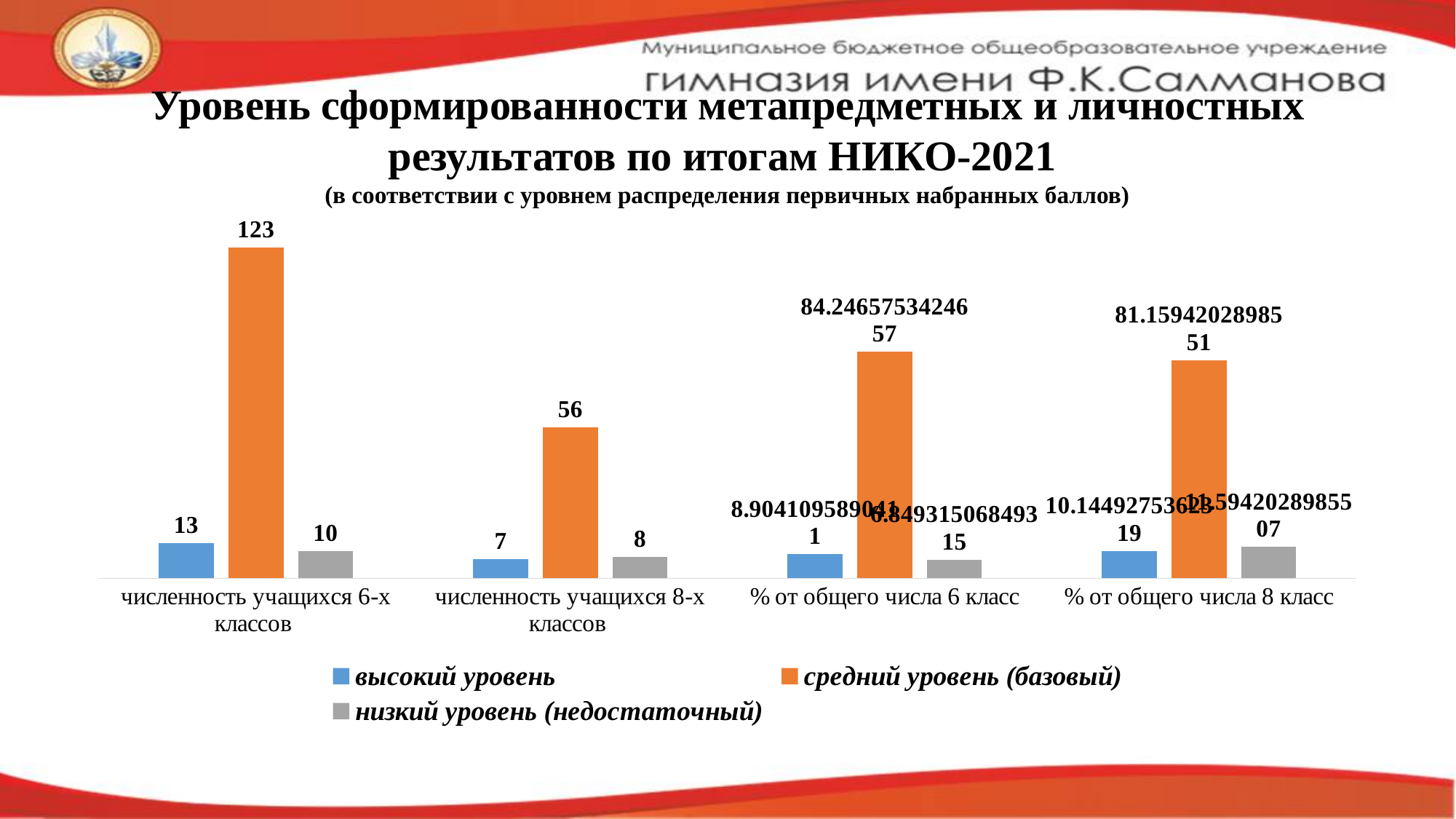
What is the value of the 'низкий уровень (недостаточный)' series for 'численность учащихся 8-х классов'? 8 What is the difference between the 'средний уровень (базовый)' and 'низкий уровень (недостаточный)' values for 'численность учащихся 8-х классов'? 48 What is the value of the 'средний уровень (базовый)' series for 'численность учащихся 8-х классов'? 56 What kind of chart is shown on the slide? bar chart What is the value of the 'высокий уровень' series for 'численность учащихся 6-х классов'? 13 What is the difference between the 'средний уровень (базовый)' and 'высокий уровень' values for 'численность учащихся 6-х классов'? 110 Which is larger: the 'высокий уровень' value for 'численность учащихся 6-х классов' or for 'численность учащихся 8-х классов'? численность учащихся 6-х классов How many categories are shown on the x axis? 4 Which category has the highest 'средний уровень (базовый)' bar? численность учащихся 6-х классов What is the value of the 'высокий уровень' series for 'численность учащихся 8-х классов'? 7 What is the value of the 'средний уровень (базовый)' series for 'численность учащихся 6-х классов'? 123 How many series does the legend list? 3